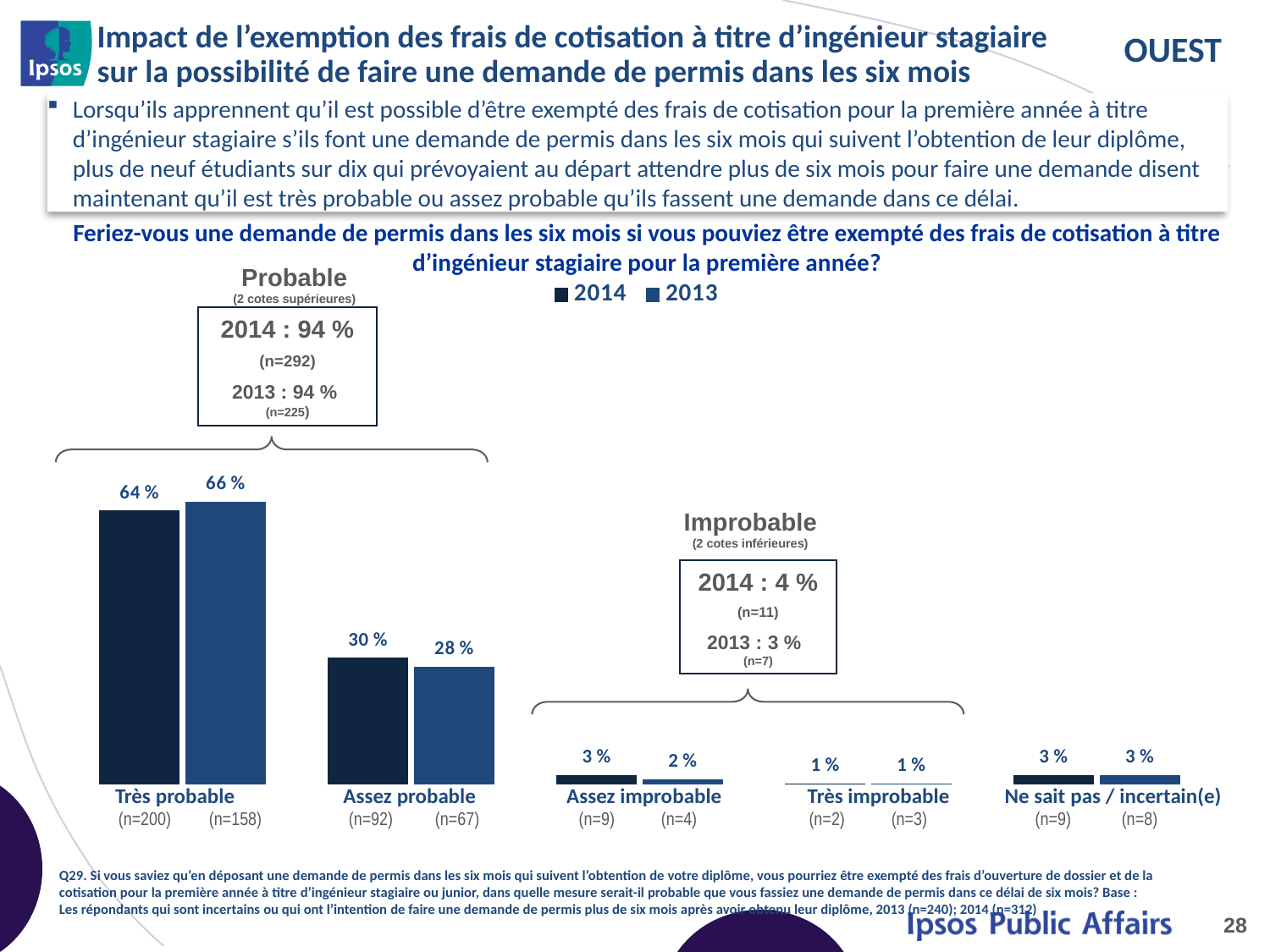
Which category has the highest 2014 value? Très probable For "Assez probable", which year has the larger value, 2014 or 2013? 2014 What is the 2014 value for "Ne sait pas / incertain(e)"? 3 % What is the 2013 value for "Assez probable"? 28 % Which category has the lowest 2013 value? Très improbable What is the 2013 value for "Assez improbable"? 2 % What kind of chart is shown on the slide? Bar chart How many categories are shown on the x axis of the chart? 5 What are the two series named in the chart legend? 2014 and 2013 How many series does the chart legend list? 2 What is the 2014 value for "Très probable"? 64 % What is the difference between the 2013 and 2014 values for "Très probable"? 2 %